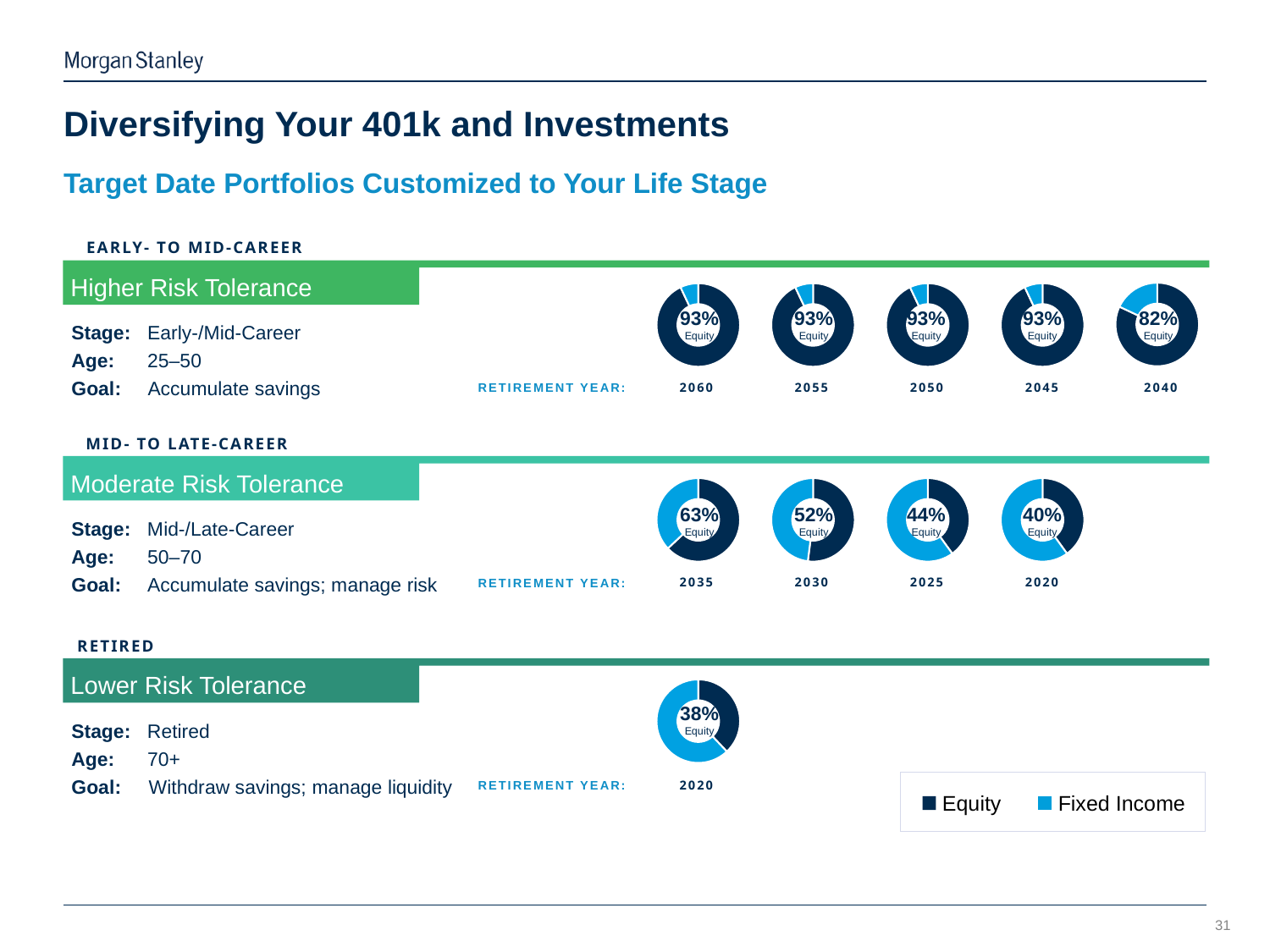
In the Moderate Risk Tolerance row, what share of the 2020 retirement year chart is Fixed Income? 60% In the Moderate Risk Tolerance row, what is the equity percentage for the 2030 retirement year chart? 52% How many donut charts are shown in the Higher Risk Tolerance row? 5 How many donut charts are shown in the Moderate Risk Tolerance row? 4 In the Moderate Risk Tolerance row, which retirement year chart has the highest equity percentage? 2035 In the Lower Risk Tolerance (Retired) row, what is the equity percentage for the 2020 retirement year chart? 38% In the Higher Risk Tolerance row, is the equity percentage for the 2060 chart larger or smaller than for the 2040 chart? Larger What is the difference in equity percentage between the 2035 chart and the 2025 chart in the Moderate Risk Tolerance row? 19% In the Higher Risk Tolerance row, what is the equity percentage for the 2040 retirement year chart? 82% In the Moderate Risk Tolerance row, which retirement year chart has the lowest equity percentage? 2020 How many series does the legend list? 2 What type of charts are used to show the equity allocations on this slide? Donut (pie) charts